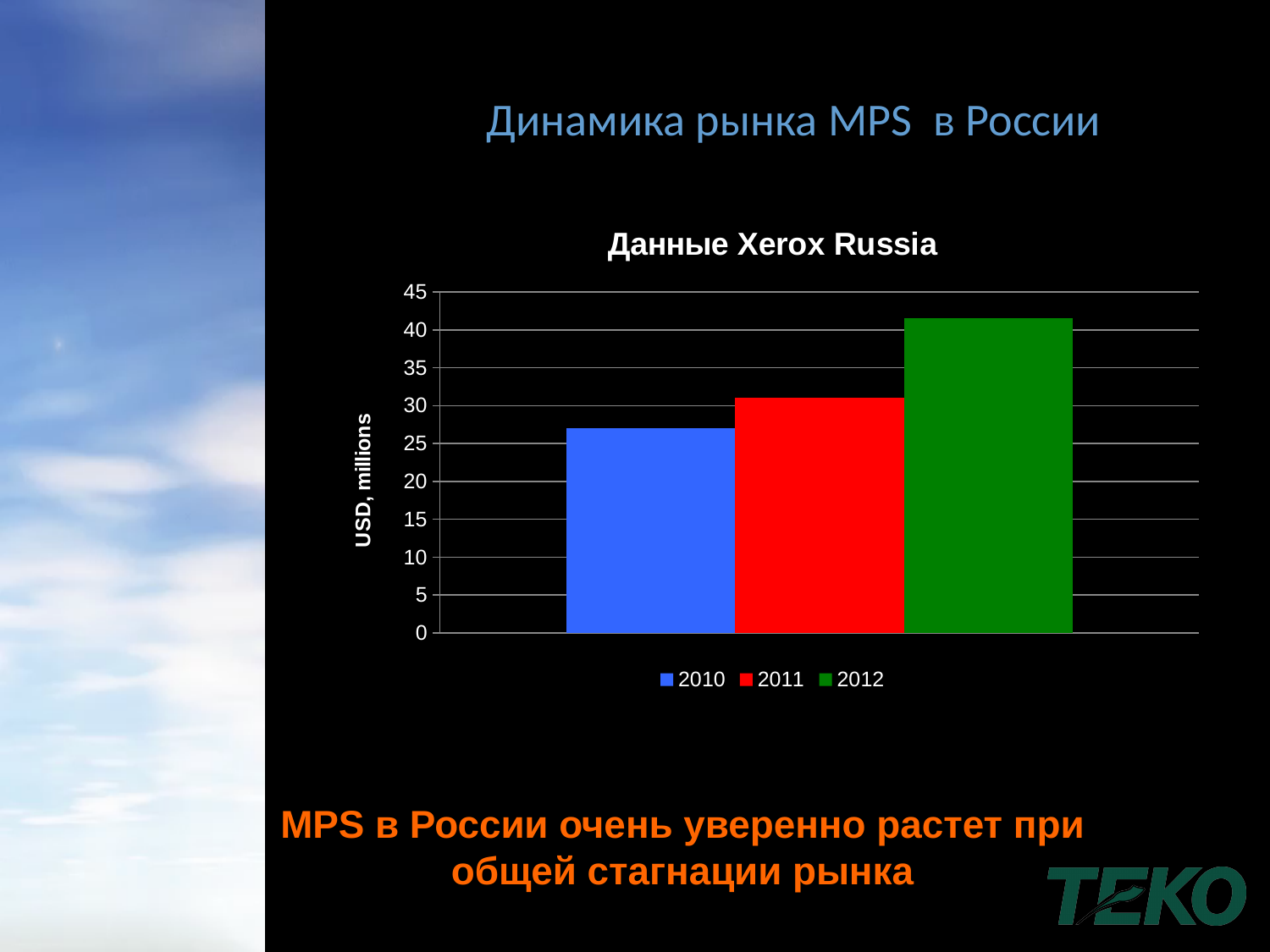
How many series does the legend list? 3 Is the value for 2010 greater or less than 25? greater What kind of chart is shown on the slide? bar chart Is the value for 2012 greater or less than 40? greater What is the label on the vertical axis? USD, millions Which year has the highest value? 2012 Which year has the lowest value? 2010 Do the values rise or fall from 2010 to 2012? rise Is the value for 2010 greater or less than 30? less Which is larger, the value for 2010 or the value for 2012? 2012 What is the title of the chart? Данные Xerox Russia